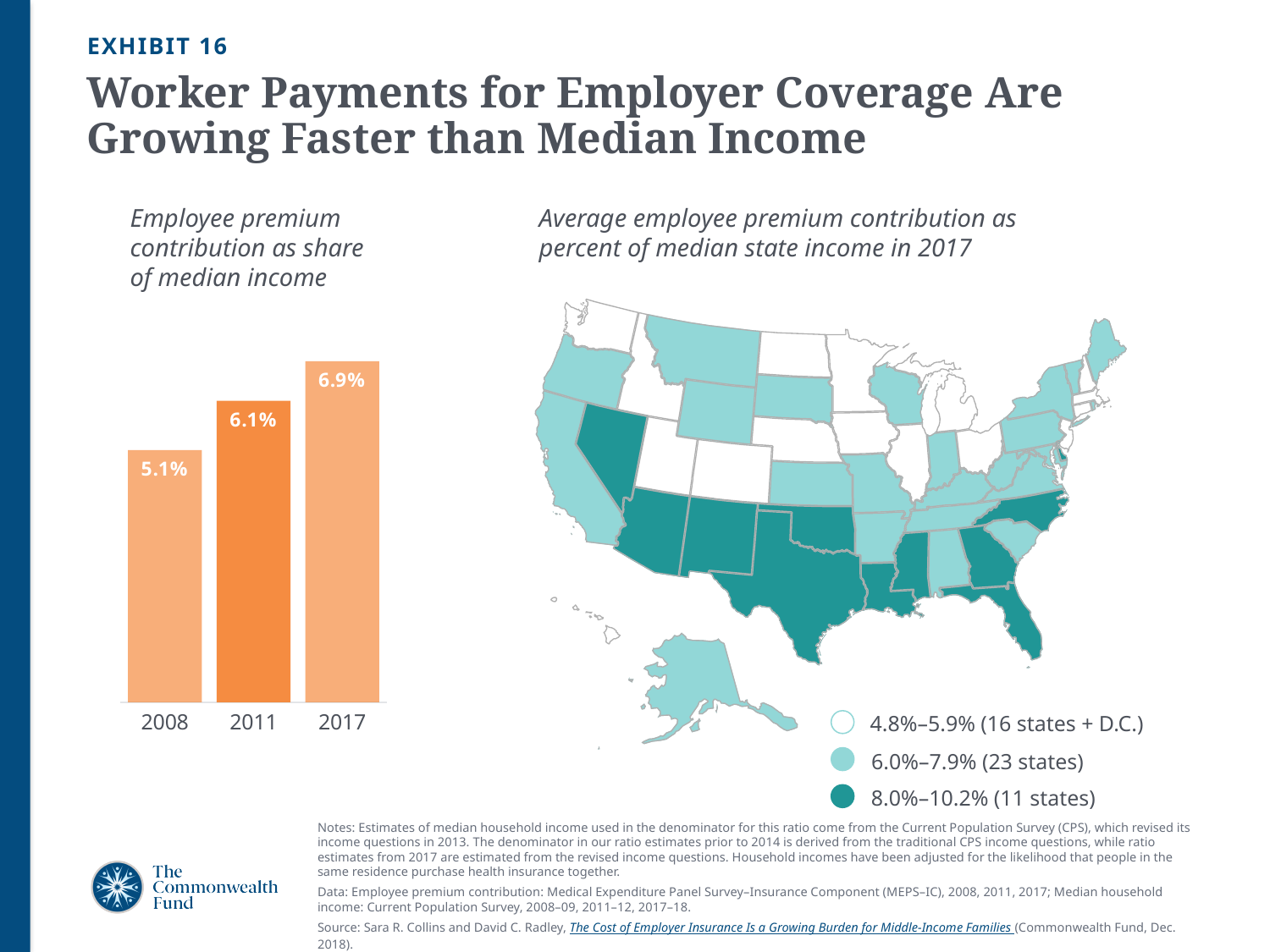
What kind of chart is shown on the left side of the slide? bar chart In the bar chart on the left, which year has the highest employee premium contribution as a share of median income? 2017 In the bar chart on the left, by how many percentage points did the employee premium contribution share rise from 2008 to 2017? 1.8 percentage points In the bar chart on the left, by how many percentage points did the employee premium contribution share rise from 2011 to 2017? 0.8 percentage points In the bar chart on the left, do the values rise or fall from 2008 to 2017? rise According to the map legend on the right, how many states had an average employee premium contribution of 8.0%–10.2% of median state income in 2017? 11 states In the bar chart on the left, what was the employee premium contribution as a share of median income in 2008? 5.1% In the bar chart on the left, what was the employee premium contribution as a share of median income in 2011? 6.1% In the bar chart on the left, is the value for 2011 larger or smaller than the value for 2008? larger In the bar chart on the left, what was the employee premium contribution as a share of median income in 2017? 6.9% In the bar chart on the left, which year has the lowest employee premium contribution as a share of median income? 2008 How many years are shown in the bar chart on the left? 3